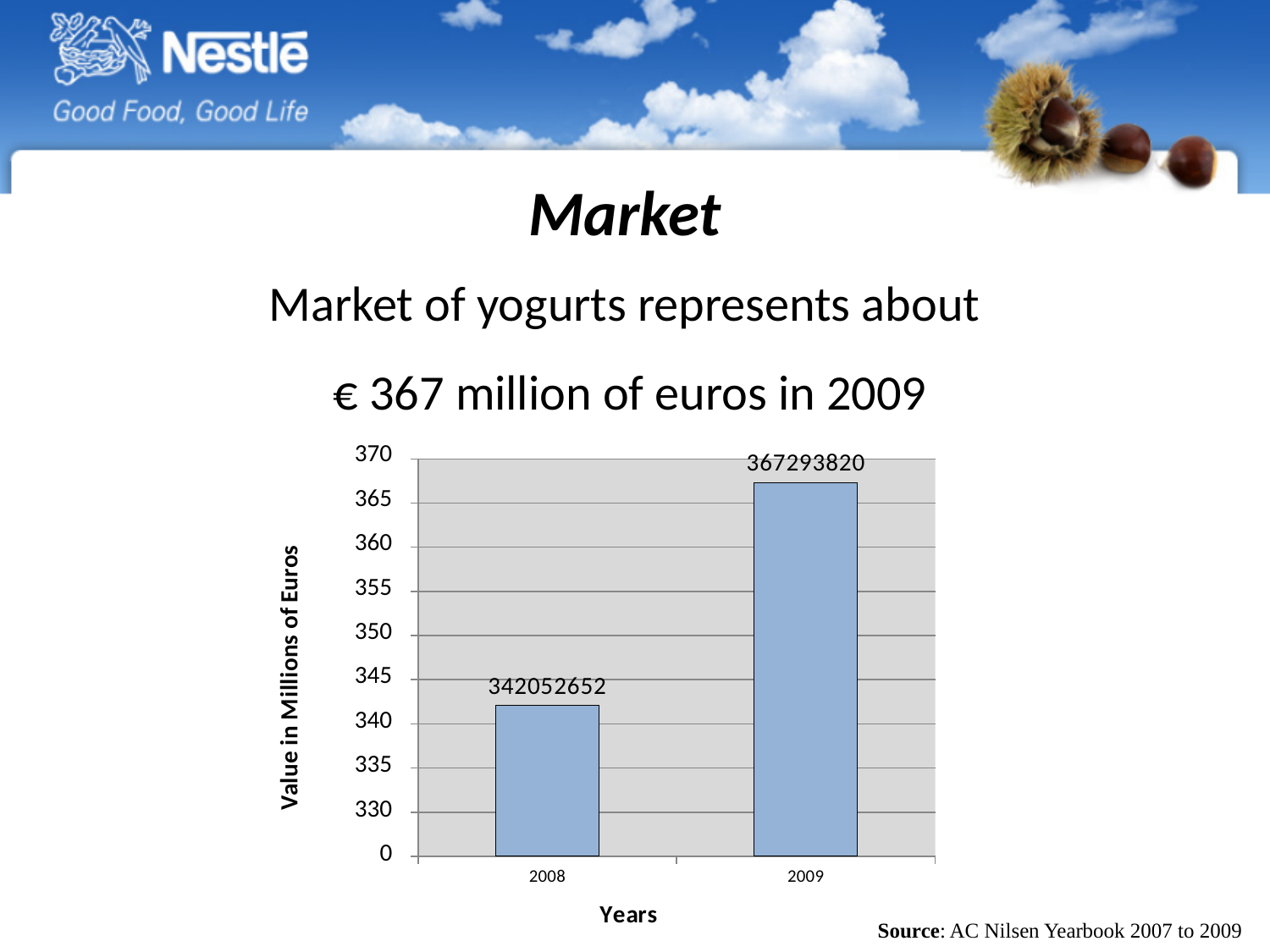
What is the value shown for 2008? 342052652 What is the value shown for 2009? 367293820 Which year has the highest value? 2009 What is the difference between the 2009 value and the 2008 value? 25241168 Is the value for 2008 greater or less than 340? greater Which year has the lowest value? 2008 Do the values rise or fall from 2008 to 2009? rise What kind of chart is shown on the slide? bar chart What is the label of the vertical axis? Value in Millions of Euros Is the value for 2009 greater or less than 365? greater Which is larger, the value for 2008 or the value for 2009? 2009 How many years are shown on the x axis? 2